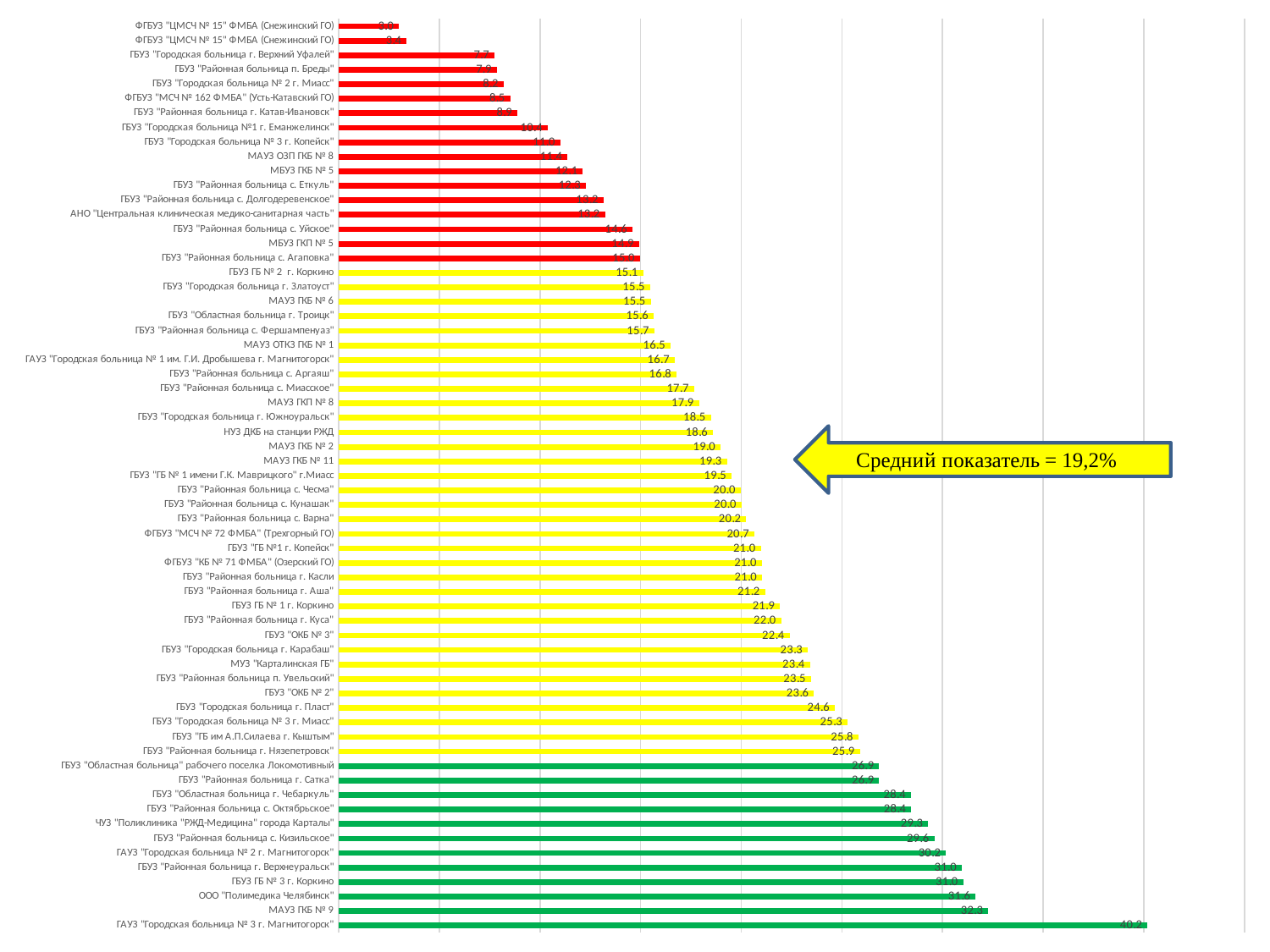
What is the value for ГБУЗ "ОКБ № 3"? 22.4 What is the value for ГБУЗ "Районная больница г. Сатка"? 26.9 What average value (Средний показатель) is stated in the callout on the slide? 19,2% What kind of chart is shown on the slide? Bar chart Which organisation has the highest value on the chart? ГАУЗ "Городская больница № 3 г. Магнитогорск" Which has the larger value: ГБУЗ "Городская больница г. Пласт" or ГБУЗ "Городская больница г. Карабаш"? ГБУЗ "Городская больница г. Пласт" What is the value for ГБУЗ "Районная больница с. Аргаяш"? 16.8 What is the difference between the values for ГАУЗ "Городская больница № 3 г. Магнитогорск" and МАУЗ ГКБ № 9? 7.9 How many green bars are there on the chart? 12 What is the value for МАУЗ ГКБ № 11? 19.3 What is the value for МАУЗ ГКБ № 9? 32.3 What is the value for ГАУЗ "Городская больница № 3 г. Магнитогорск"? 40.2